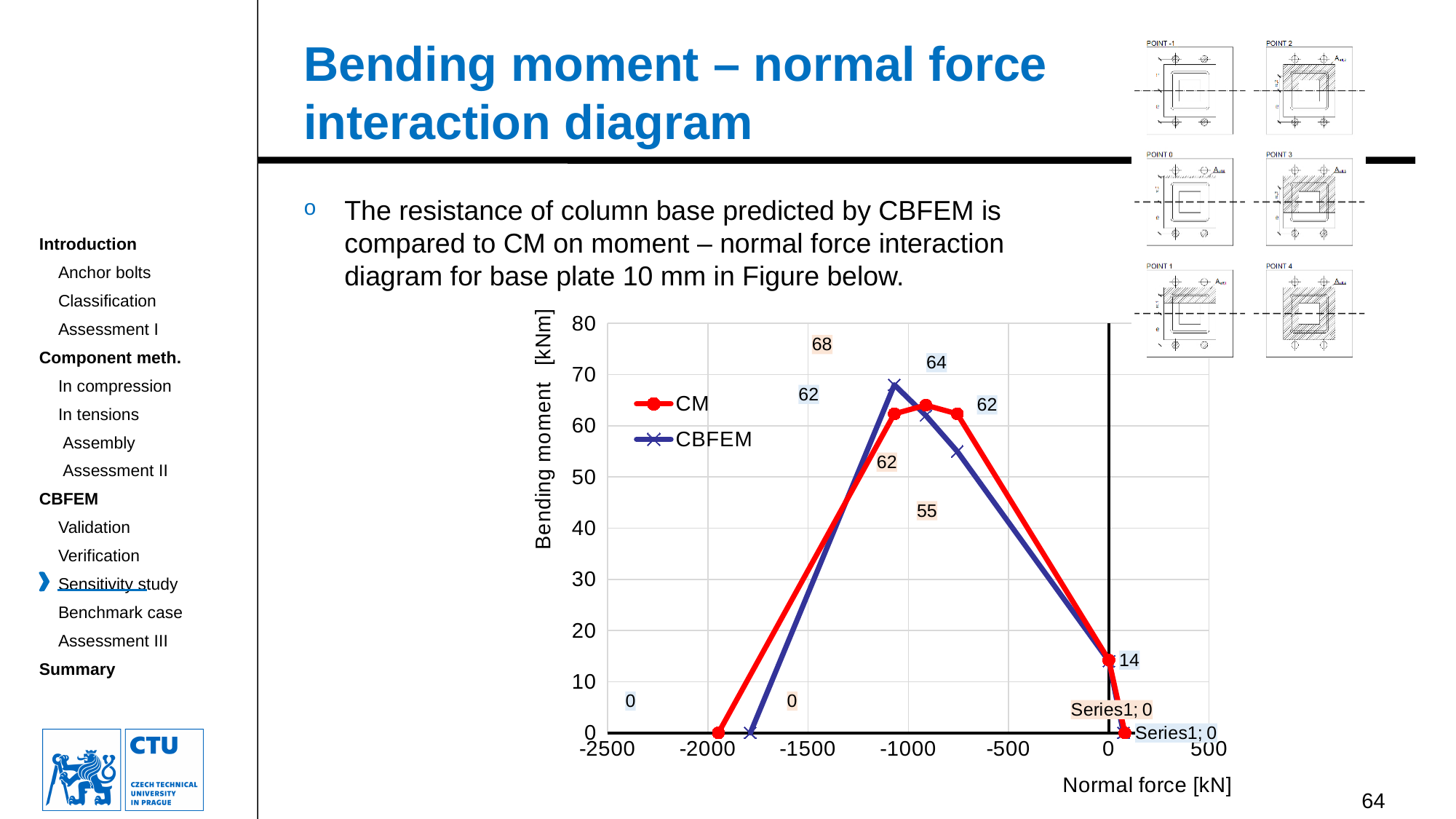
How many series does the chart legend list? 2 Is the peak bending moment of the CBFEM series greater or less than 60 kNm? greater What is the maximum value shown on the vertical axis of the chart? 80 What kind of chart is shown on the slide? line chart What is the peak bending moment labelled for the CM series? 64 Does the bending moment of the CM series rise or fall as the normal force goes from -1000 kN to 0 kN? fall Which series reaches the higher peak bending moment, CM or CBFEM? CBFEM Is the bending moment at a normal force of 0 kN greater or less than 20 kNm? less What is the highest bending moment value labelled on the chart? 68 What is the label of the vertical axis of the chart? Bending moment [kNm] What are the two series named in the chart legend? CM and CBFEM What bending moment value is labelled where the two curves meet at a normal force of 0 kN? 14